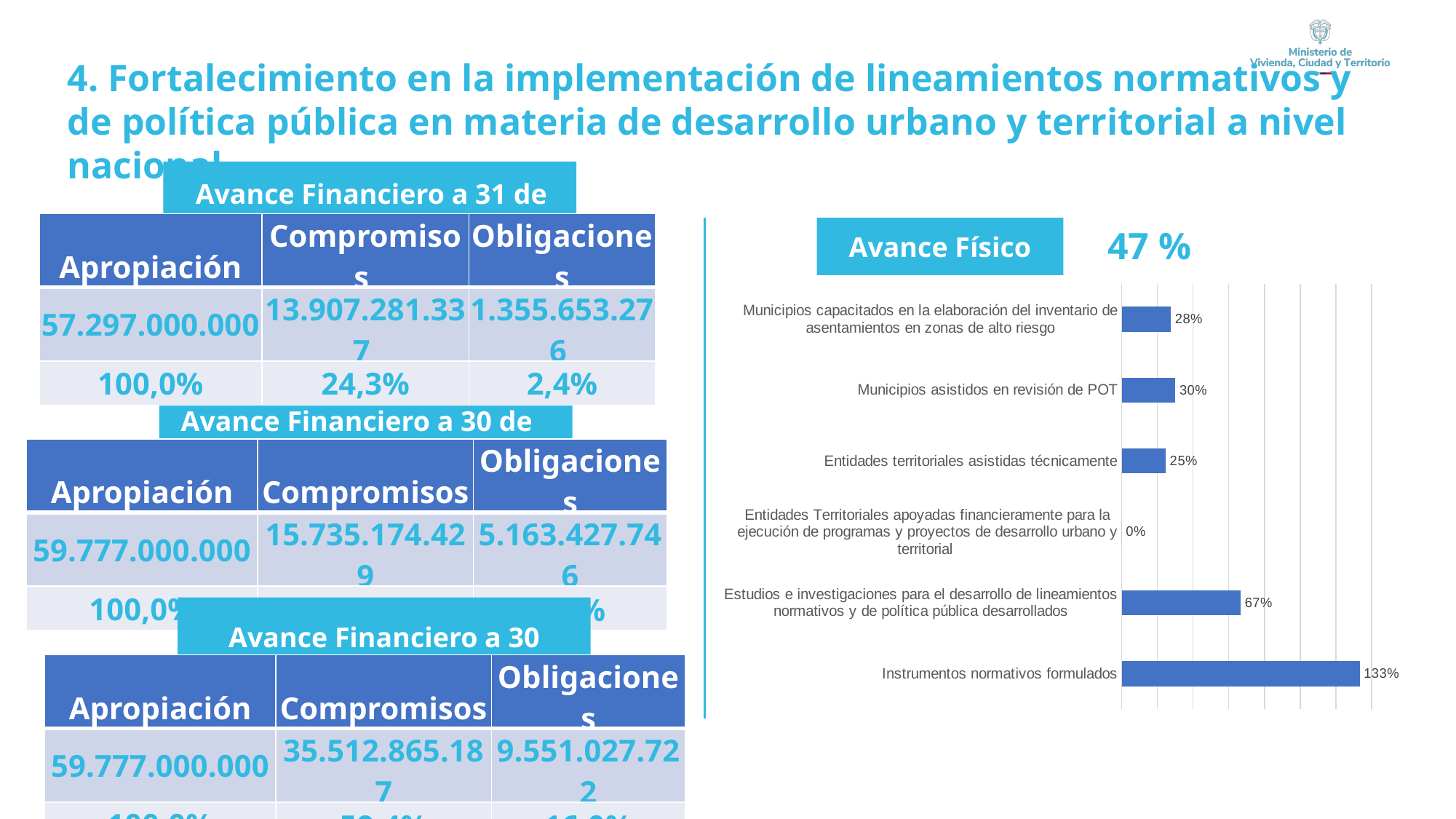
Which is larger: the value for "Municipios asistidos en revisión de POT" or the value for "Entidades territoriales asistidas técnicamente"? Municipios asistidos en revisión de POT What is the value for "Municipios capacitados en la elaboración del inventario de asentamientos en zonas de alto riesgo"? 28% What is the difference between the values for "Municipios asistidos en revisión de POT" and "Municipios capacitados en la elaboración del inventario de asentamientos en zonas de alto riesgo"? 2% What is the value for "Instrumentos normativos formulados"? 133% What is the value for "Municipios asistidos en revisión de POT"? 30% What is the value for "Entidades territoriales asistidas técnicamente"? 25% How many categories does the bar chart show? 6 What type of chart is shown on the slide? bar chart Which category has the highest value in the bar chart? Instrumentos normativos formulados Which category has the lowest value in the bar chart? Entidades Territoriales apoyadas financieramente para la ejecución de programas y proyectos de desarrollo urbano y territorial What is the title shown above the bar chart? Avance Físico What is the difference between the values for "Instrumentos normativos formulados" and "Estudios e investigaciones para el desarrollo de lineamientos normativos y de política pública desarrollados"? 66%